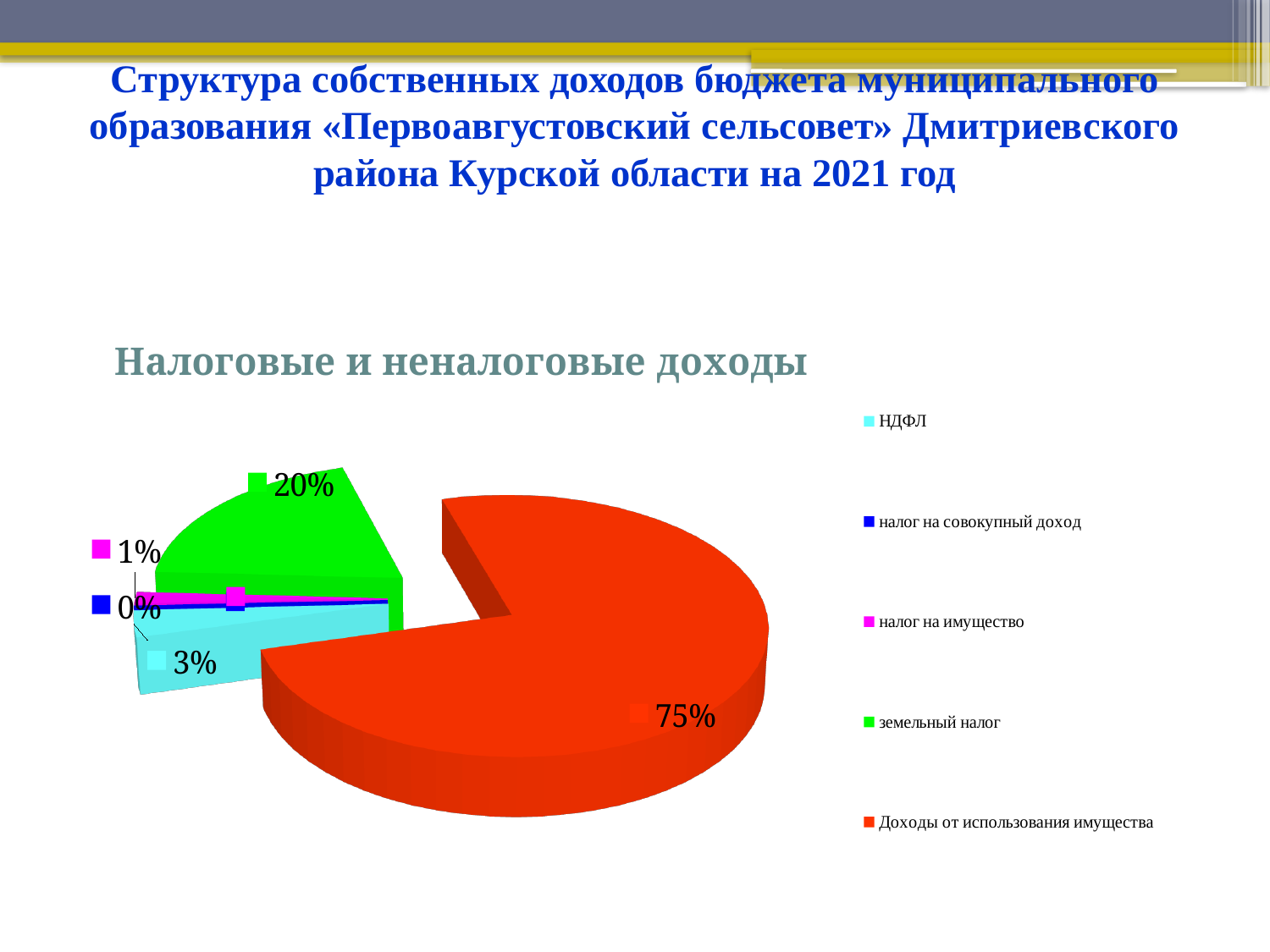
How many categories does the legend of the pie chart list? 5 What is the difference between the shares of Доходы от использования имущества and земельный налог? 55% Which is larger, the share of земельный налог or the share of НДФЛ? земельный налог What is the title of the chart? Налоговые и неналоговые доходы Which category has the smallest share of the pie? налог на совокупный доход What kind of chart is shown on the slide? pie chart What share of the pie does налог на имущество have? 1% What share of the pie does Доходы от использования имущества have? 75% What share of the pie does НДФЛ have? 3% Which category has the largest share of the pie? Доходы от использования имущества